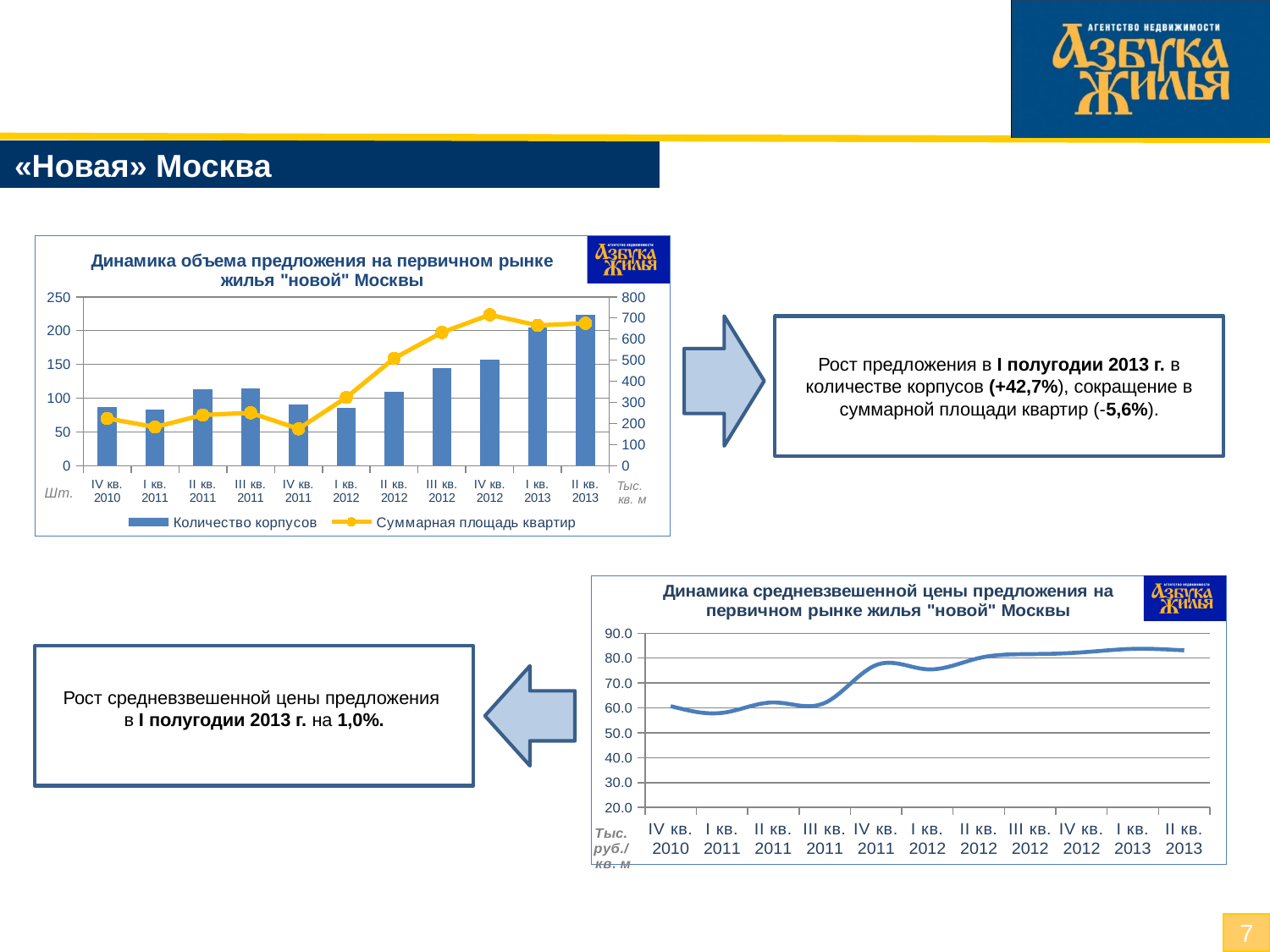
In the top chart "Динамика объема предложения на первичном рынке жилья "новой" Москвы", which quarter has the tallest bar for Количество корпусов? II кв. 2013 In the bottom chart "Динамика средневзвешенной цены предложения на первичном рынке жилья "новой" Москвы", what kind of chart is it? Line chart In the bottom chart "Динамика средневзвешенной цены предложения на первичном рынке жилья "новой" Москвы", is the value for IV кв. 2010 greater or less than 70.0? less In the bottom chart "Динамика средневзвешенной цены предложения на первичном рынке жилья "новой" Москвы", do the values generally rise or fall from IV кв. 2010 to II кв. 2013? Rise In the top chart "Динамика объема предложения на первичном рынке жилья "новой" Москвы", which is larger for Количество корпусов: IV кв. 2010 or II кв. 2013? II кв. 2013 In the top chart "Динамика объема предложения на первичном рынке жилья "новой" Москвы", is the Количество корпусов value for II кв. 2013 greater or less than 200? greater In the top chart "Динамика объема предложения на первичном рынке жилья "новой" Москвы", how many series does the legend list? 2 In the top chart "Динамика объема предложения на первичном рынке жилья "новой" Москвы", is the Суммарная площадь квартир value for II кв. 2012 greater or less than 400? greater In the top chart "Динамика объема предложения на первичном рынке жилья "новой" Москвы", what are the two legend entries? Количество корпусов and Суммарная площадь квартир In the top chart "Динамика объема предложения на первичном рынке жилья "новой" Москвы", which quarter has the highest value for Суммарная площадь квартир? IV кв. 2012 In the top chart "Динамика объема предложения на первичном рынке жилья "новой" Москвы", what kind of chart is it? A combination bar and line chart In the top chart "Динамика объема предложения на первичном рынке жилья "новой" Москвы", how many quarters are shown on the x axis? 11